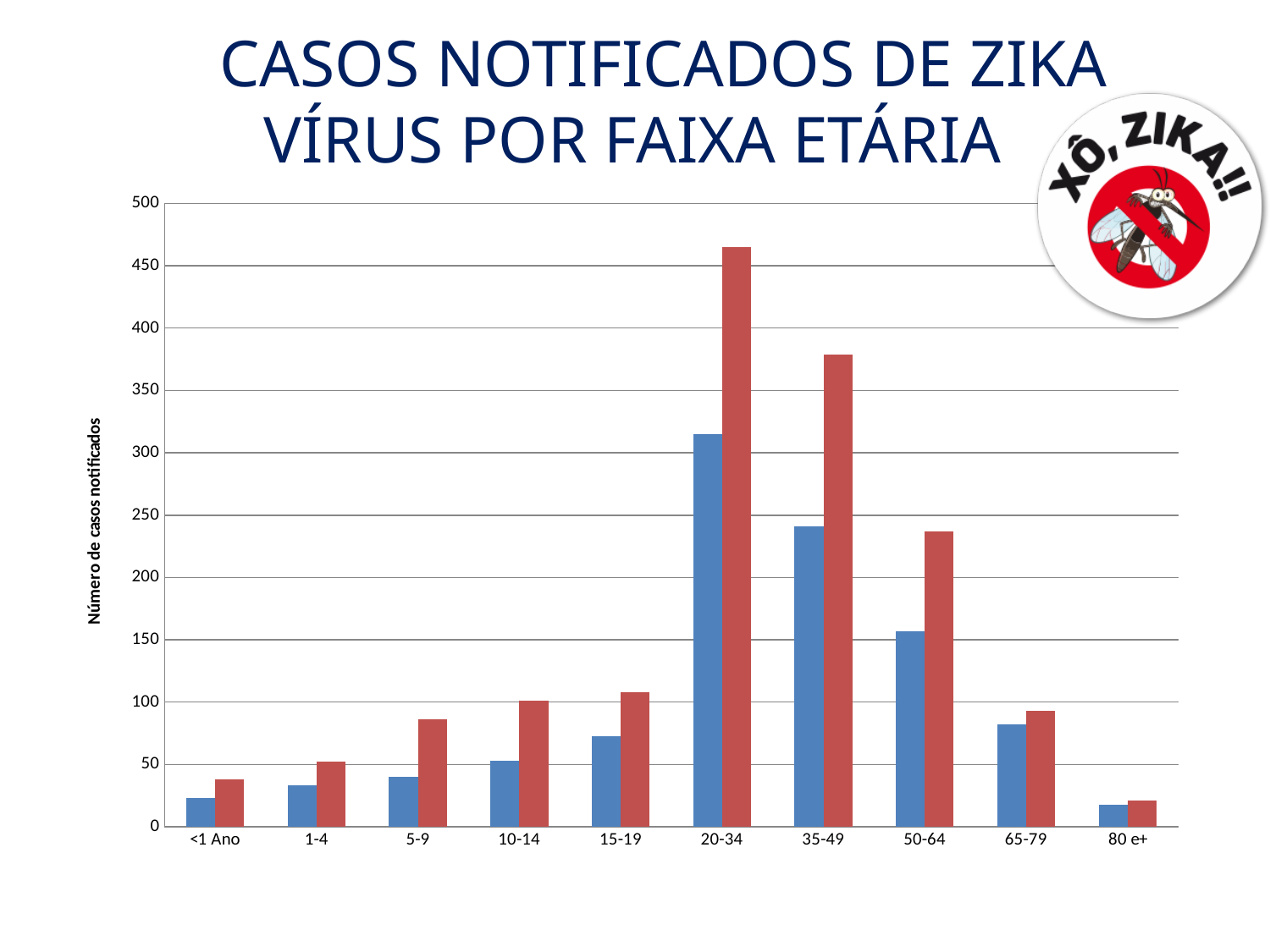
Which age group has the highest red bar? 20-34 How many bars are plotted for each age group? 2 How many age-group categories are shown on the x axis? 10 Is the blue bar for 20-34 greater or less than 300? greater Do the red bars rise or fall from 20-34 to 80 e+ along the x axis? fall Is the red bar for 20-34 greater or less than 450? greater Which age group has the lowest blue bar? 80 e+ Is the blue bar for 15-19 greater or less than 100? less Which is larger: the red bar for 35-49 or the red bar for 50-64? the red bar for 35-49 For the 20-34 age group, which bar is larger, the blue one or the red one? the red one What kind of chart is shown on the slide? bar chart